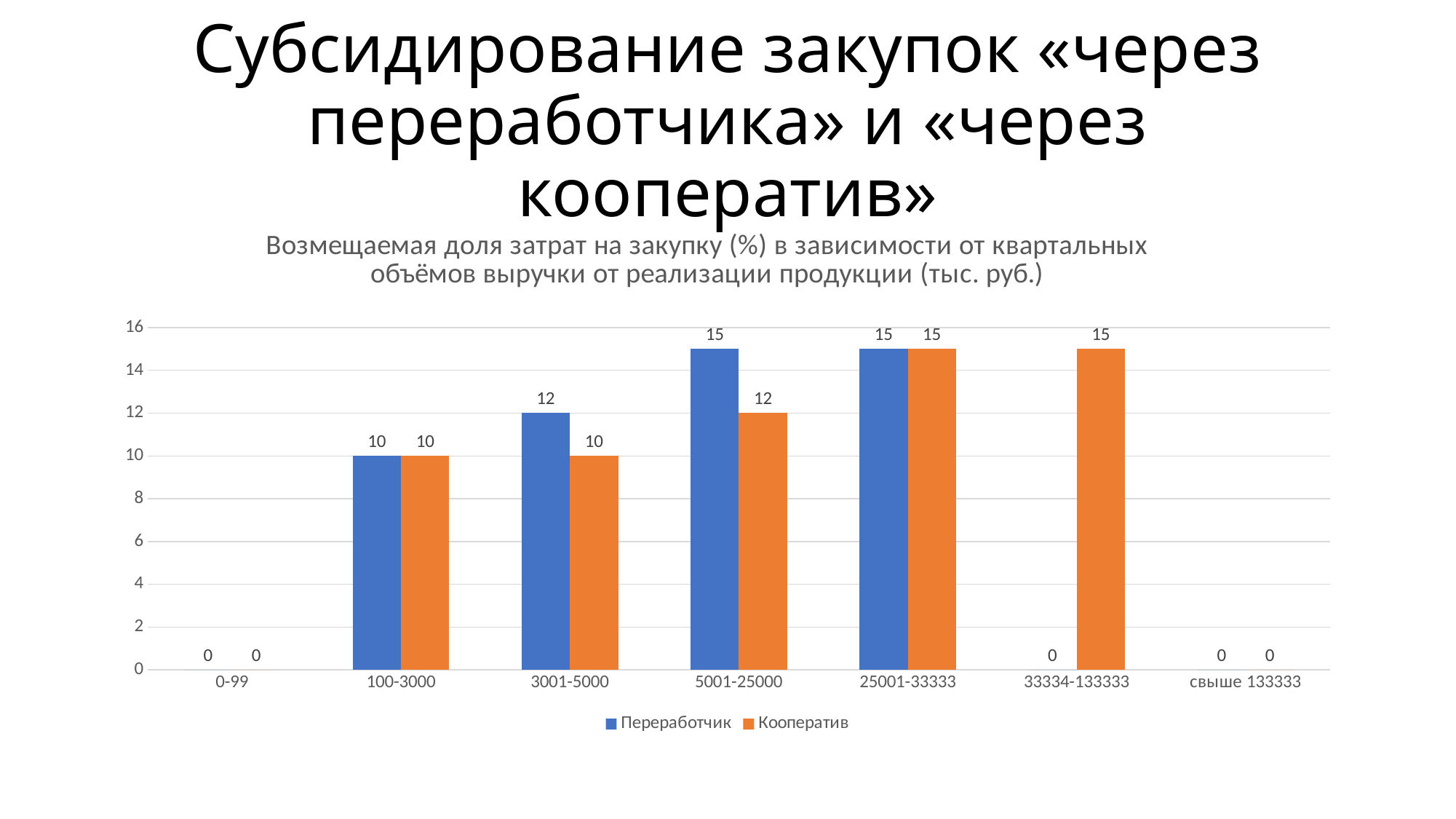
What is the value for Переработчик in the 33334-133333 category? 0 Which series has the larger value in the 3001-5000 category, Переработчик or Кооператив? Переработчик How many categories are shown on the x axis? 7 Which category has the lowest value for Кооператив among 100-3000, 3001-5000 and 5001-25000? 100-3000 and 3001-5000 (both 10) Which colour represents the Кооператив series in the legend? Orange How many series does the legend list? 2 What is the value for Переработчик in the 3001-5000 category? 12 What is the value for Кооператив in the 5001-25000 category? 12 Which series has the larger value in the 33334-133333 category, Переработчик or Кооператив? Кооператив What is the difference between Переработчик and Кооператив in the 5001-25000 category? 3 What is the value for Кооператив in the 33334-133333 category? 15 What type of chart is shown on the slide? Bar chart